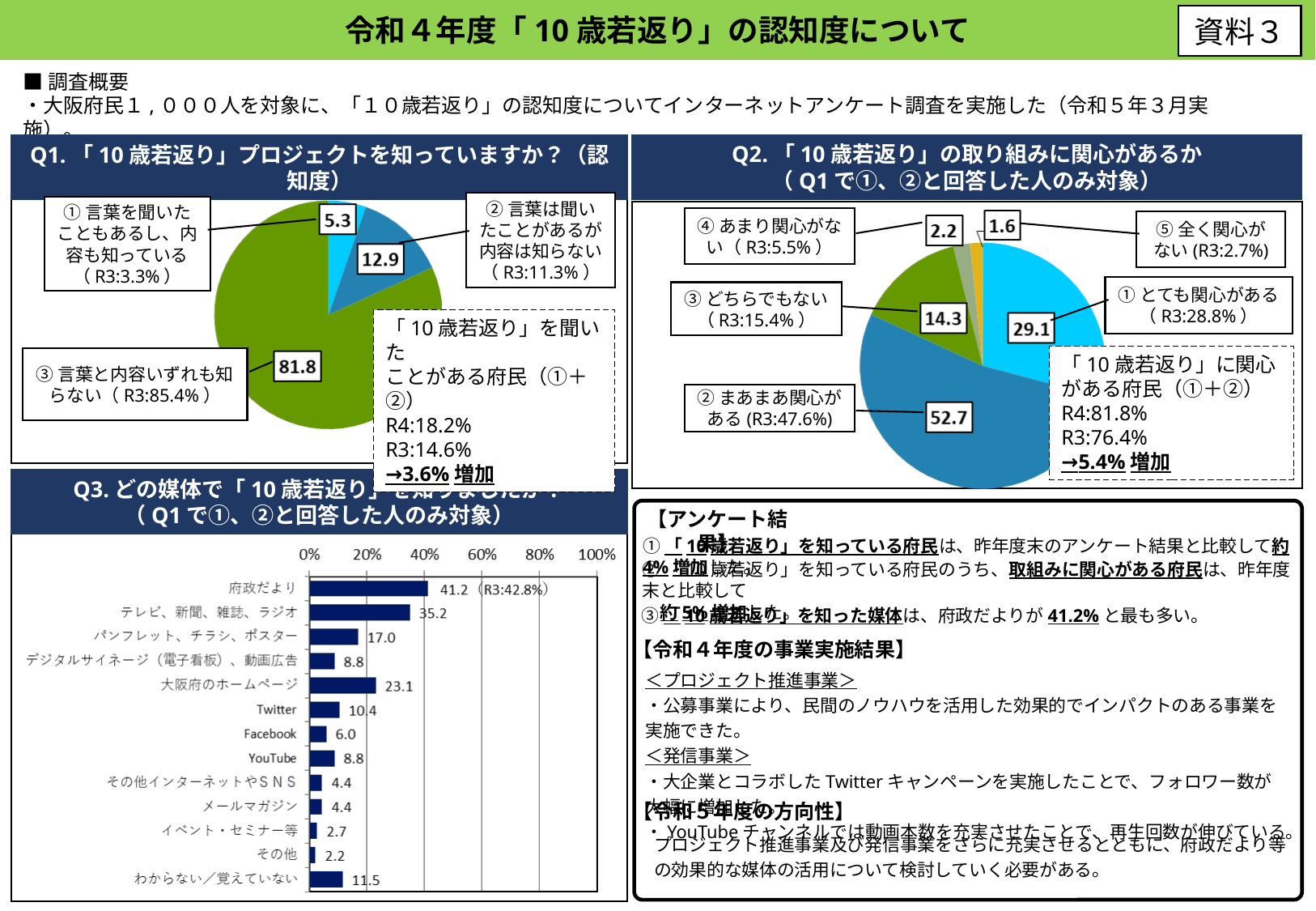
In the Q1 pie chart, what is the value for ① 言葉を聞いたこともあるし、内容も知っている? 5.3 In the Q2 pie chart, which category has the largest value? ② まあまあ関心がある In the Q3 bar chart, how many categories are shown? 13 In the Q1 pie chart, what is the difference between the values for ② 言葉は聞いたことがあるが内容は知らない and ① 言葉を聞いたこともあるし、内容も知っている? 7.6 In the Q3 bar chart, what is the value for 大阪府のホームページ? 23.1 In the Q2 pie chart, which category has the smallest value? ⑤ 全く関心がない In the Q3 chart, what kind of chart is used? Bar chart In the Q3 bar chart, which category has the highest value? 府政だより In the Q1 pie chart, what is the value for ③ 言葉と内容いずれも知らない? 81.8 In the Q2 pie chart, how many categories are shown? 5 In the Q2 pie chart, what is the value for ③ どちらでもない? 14.3 In the Q3 bar chart, which is larger, Twitter or Facebook? Twitter